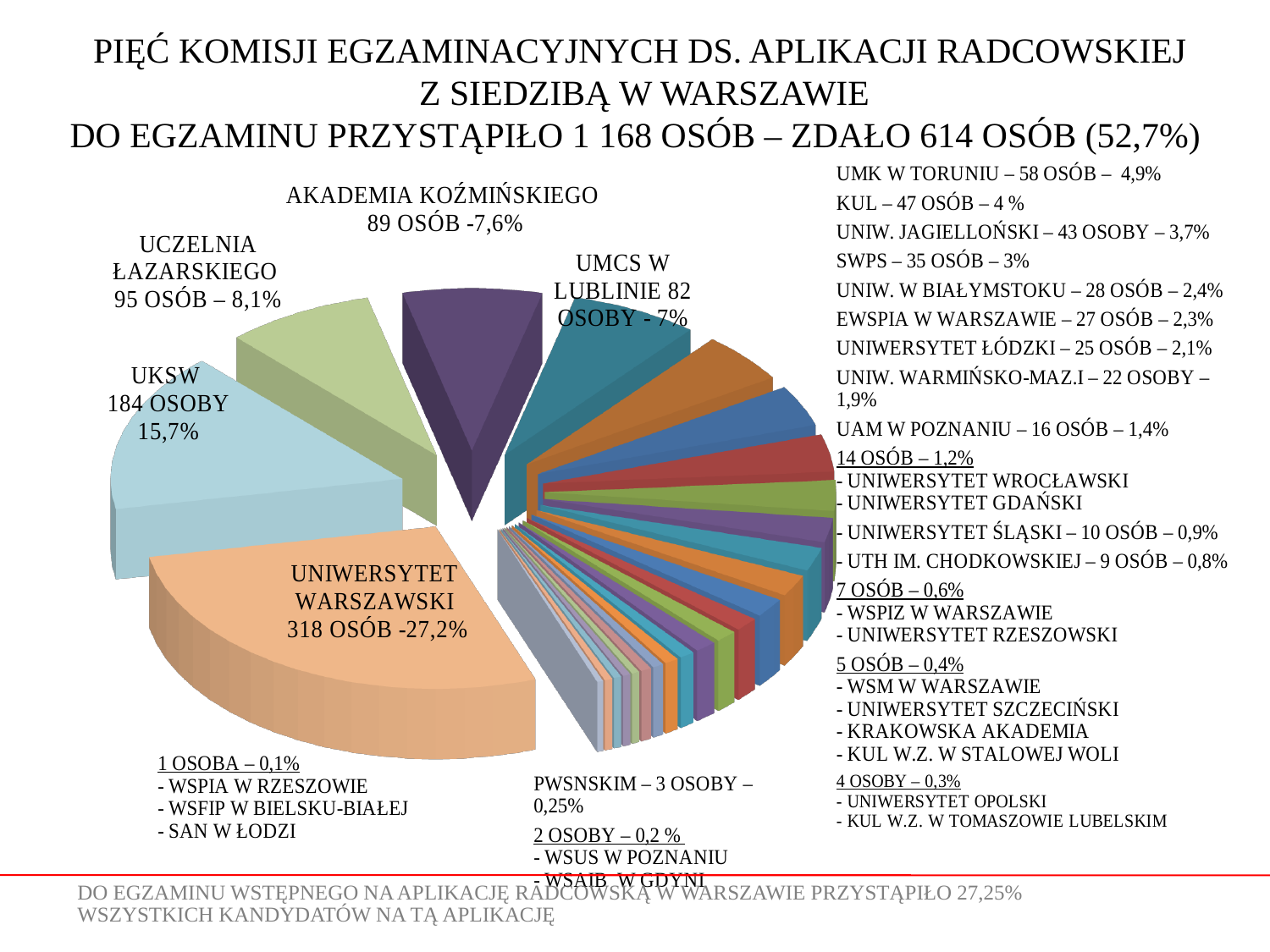
According to the title, how many people took the exam in total? 1 168 OSÓB How many people does the slice for UNIWERSYTET WARSZAWSKI represent? 318 OSÓB What percentage is shown for SWPS? 3% How many people are shown for AKADEMIA KOŹMIŃSKIEGO? 89 OSÓB What is the difference in number of people between UNIWERSYTET WARSZAWSKI and UKSW? 134 What percentage is shown for UCZELNIA ŁAZARSKIEGO? 8,1% What kind of chart is shown on the slide? pie chart What percentage share is shown for UKSW? 15,7% Which institution has the largest slice of the pie? UNIWERSYTET WARSZAWSKI Which is larger, the value for KUL or the value for UNIW. JAGIELLOŃSKI? KUL How many people are shown for UMK W TORUNIU? 58 OSÓB Which is larger, the value for UKSW or the value for UMCS W LUBLINIE? UKSW